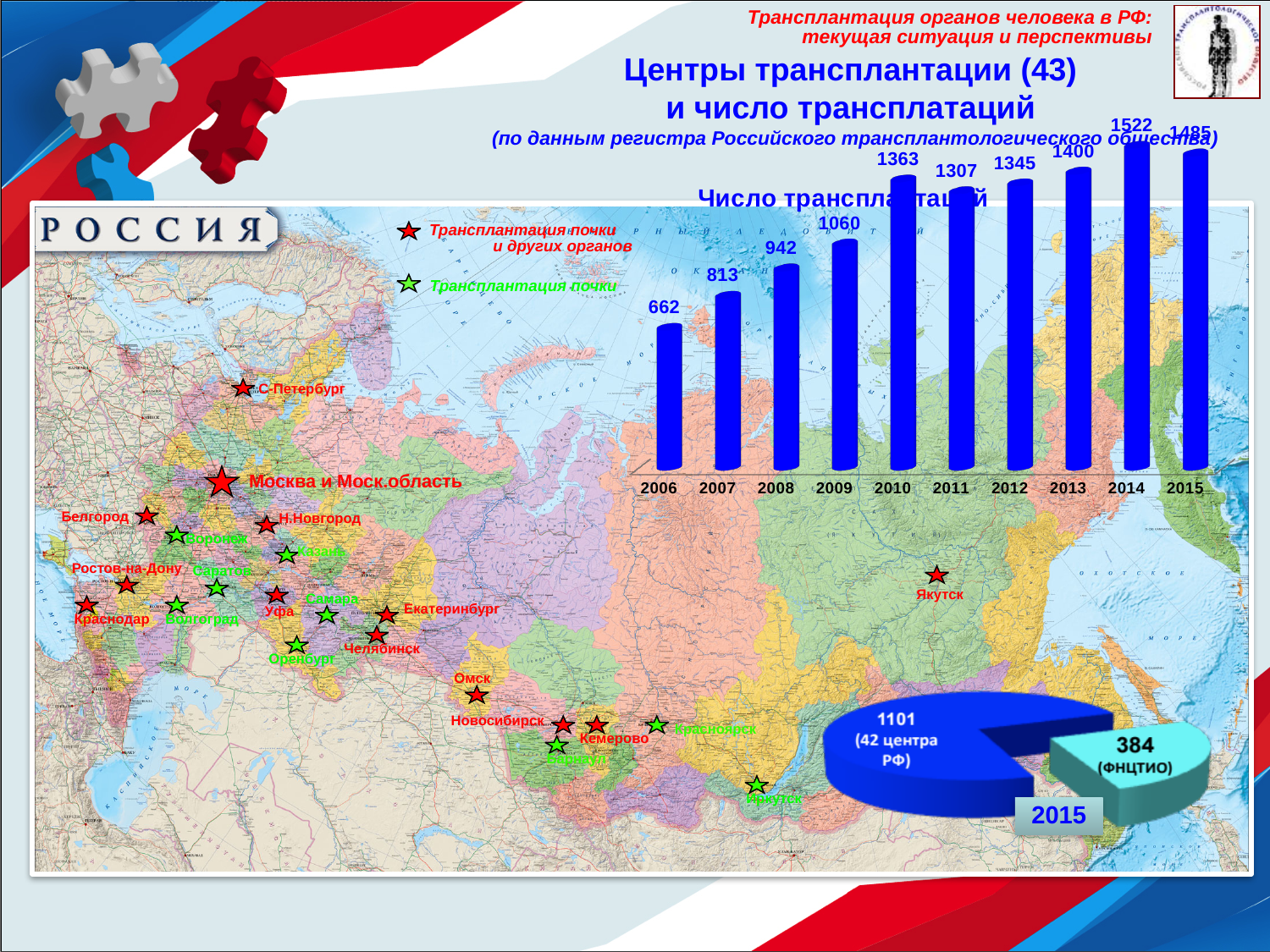
In the pie chart at the bottom right of the slide, what is the total of the two slices? 1485 In the bar chart 'Число трансплантаций', what is the value for 2010? 1363 In the bar chart 'Число трансплантаций', which year has the larger value, 2010 or 2011? 2010 In the bar chart 'Число трансплантаций', which year has the lowest value? 2006 What kind of chart is 'Число трансплантаций'? bar chart In the bar chart 'Число трансплантаций', which year has the highest value? 2014 In the bar chart 'Число трансплантаций', what is the difference between the values for 2015 and 2006? 823 In the bar chart 'Число трансплантаций', what is the value for 2006? 662 In the pie chart at the bottom right of the slide, what is the value for '42 центра РФ'? 1101 In the pie chart at the bottom right of the slide, what is the value for 'ФНЦТИО'? 384 In the bar chart 'Число трансплантаций', do the values rise or fall from 2006 to 2010? rise In the bar chart 'Число трансплантаций', how many years are shown on the x axis? 10